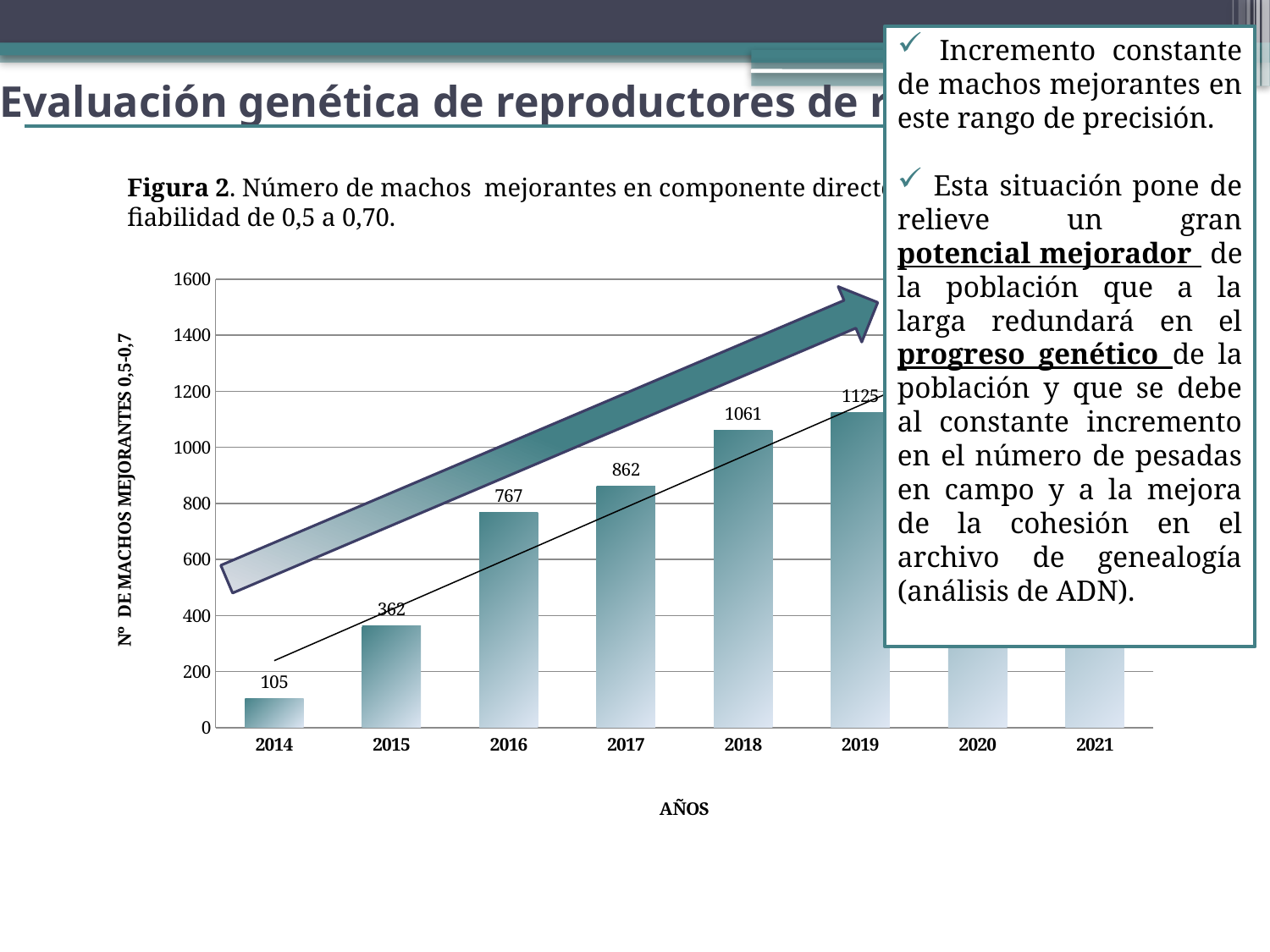
Which is larger, the value for 2017 or the value for 2016? 2017 Which year has the lowest value? 2014 Is the value for 2018 greater or less than 1000? greater Do the values rise or fall from 2014 to 2019? rise What is the value for 2014? 105 What is the difference between the values for 2016 and 2015? 405 What kind of chart is this? bar chart What is the value for 2016? 767 How many years are shown on the x axis? 8 What is the difference between the values for 2019 and 2018? 64 What is the value for 2019? 1125 What is the title of the x axis? AÑOS